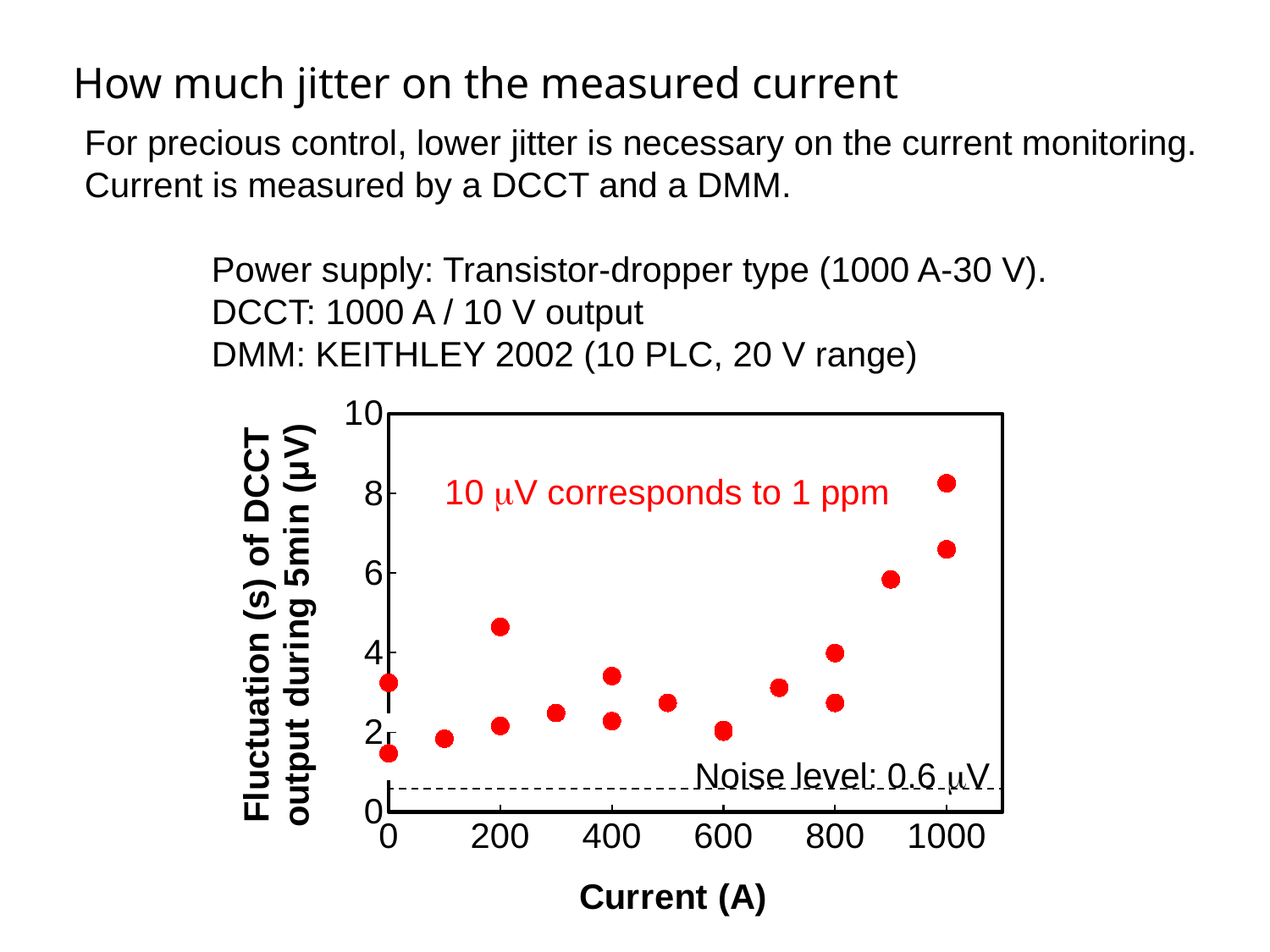
At which current does the chart show the highest fluctuation? 1000 A What noise level is indicated by the dashed line on the chart? 0.6 µV Which has the larger fluctuation: the point at 900 A or the point at 600 A? 900 A What is the maximum value shown on the y axis of the chart? 10 What is the label of the x axis of the chart? Current (A) Is the fluctuation value at 600 A greater or less than 4 µV? less What kind of chart is shown on the slide? scatter plot Are both fluctuation values at 1000 A greater or less than 6 µV? greater Do the fluctuation values generally rise or fall as the current increases from 600 A to 1000 A? rise According to the annotation on the chart, 10 µV corresponds to how many ppm? 1 ppm Is the fluctuation value at 900 A greater or less than 4 µV? greater